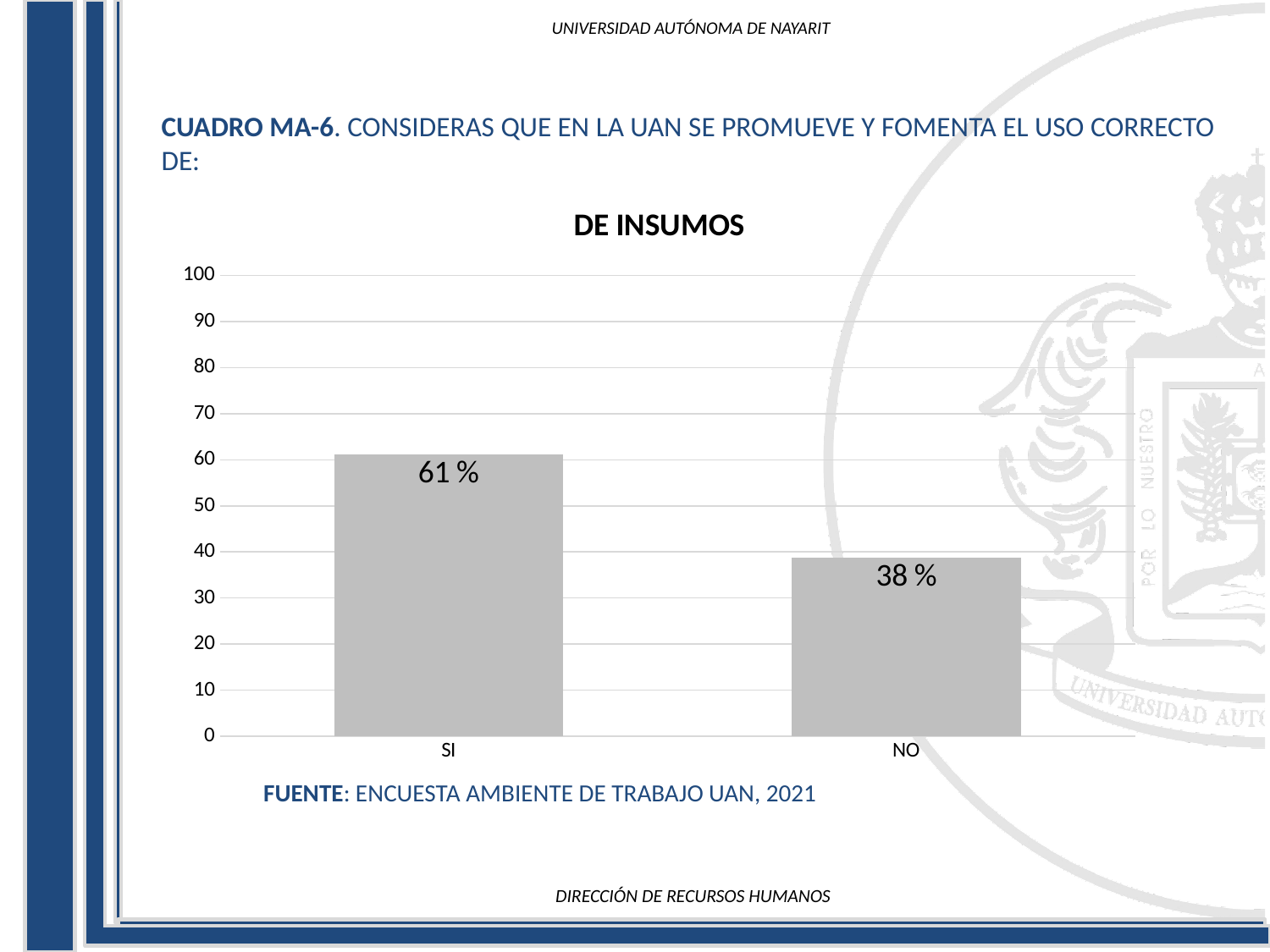
What is the title of the chart? DE INSUMOS What kind of chart is shown on the slide? bar chart Which is larger, the value for SI or the value for NO? SI Which category has the lowest value? NO What is the highest value shown on the y axis? 100 Is the value for SI greater or less than 50? greater Which category has the highest value? SI How many categories are shown on the x axis? 2 What is the difference between the values for SI and NO? 23 % Is the value for NO greater or less than 40? less What is the value for SI? 61 % What is the value for NO? 38 %